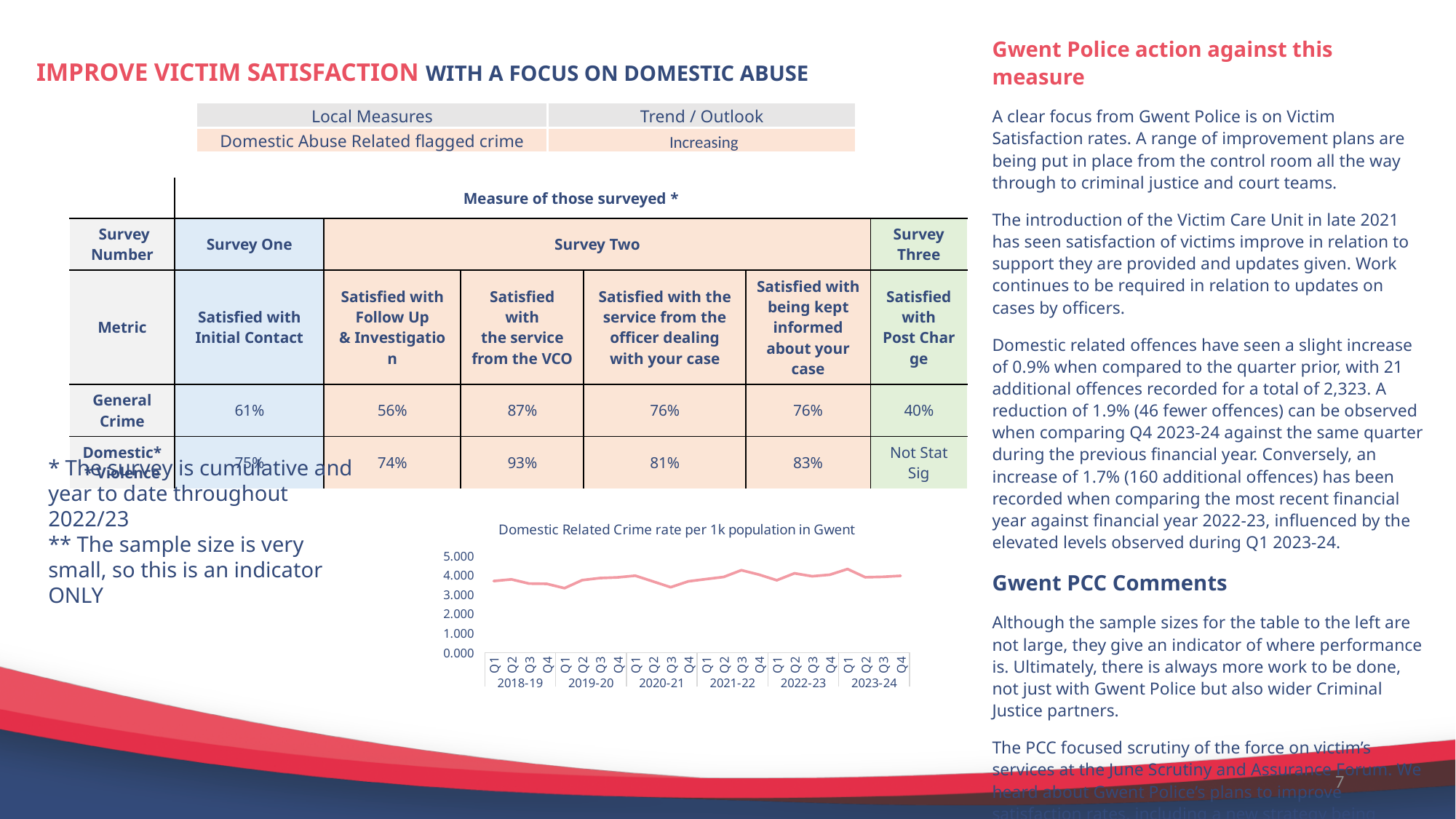
On the Domestic Related Crime rate chart, is the value for Q1 2019-20 greater or less than 4.000? less What is the highest value shown on the y axis of the Domestic Related Crime rate chart? 5.000 On the Domestic Related Crime rate chart, is the value for Q2 2021-22 greater or less than 3.000? greater On the Domestic Related Crime rate chart, is the value for Q3 2020-21 greater or less than 4.000? less On the Domestic Related Crime rate chart, which is larger: the value for Q1 2023-24 or the value for Q1 2019-20? Q1 2023-24 How many financial years are shown on the x axis of the Domestic Related Crime rate chart? 6 What type of chart is shown at the bottom of the slide? line chart What is the title of the chart on the slide? Domestic Related Crime rate per 1k population in Gwent On the Domestic Related Crime rate chart, which quarter has the highest value? Q1 2023-24 How many quarterly data points are plotted on the Domestic Related Crime rate chart? 24